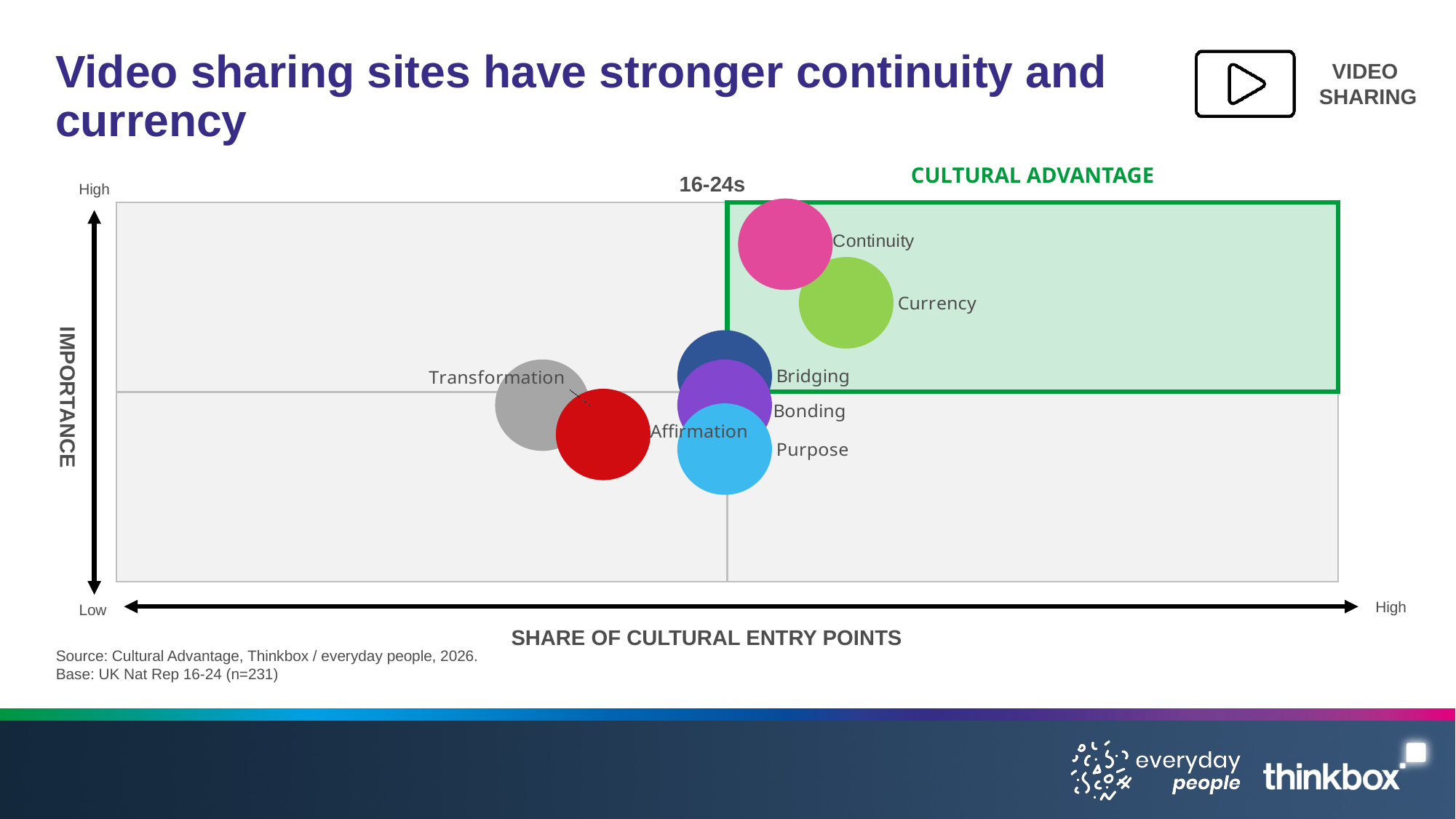
What is the label of the vertical axis of the chart? Importance Which age group does the chart cover, according to the label above it? 16-24s Which has a higher share of cultural entry points on the chart, Transformation or Purpose? Purpose Which category has the lowest share of cultural entry points on the chart? Transformation Which has higher importance on the chart, Continuity or Currency? Continuity What is the label of the horizontal axis of the chart? Share of cultural entry points Which two categories sit fully inside the green 'Cultural Advantage' zone? Continuity and Currency What kind of chart is shown on the slide? Bubble chart How many bubbles (categories) are plotted on the chart? 7 Which category has the highest share of cultural entry points on the chart? Currency Which category has the highest importance on the chart? Continuity Which has higher importance on the chart, Transformation or Affirmation? Transformation